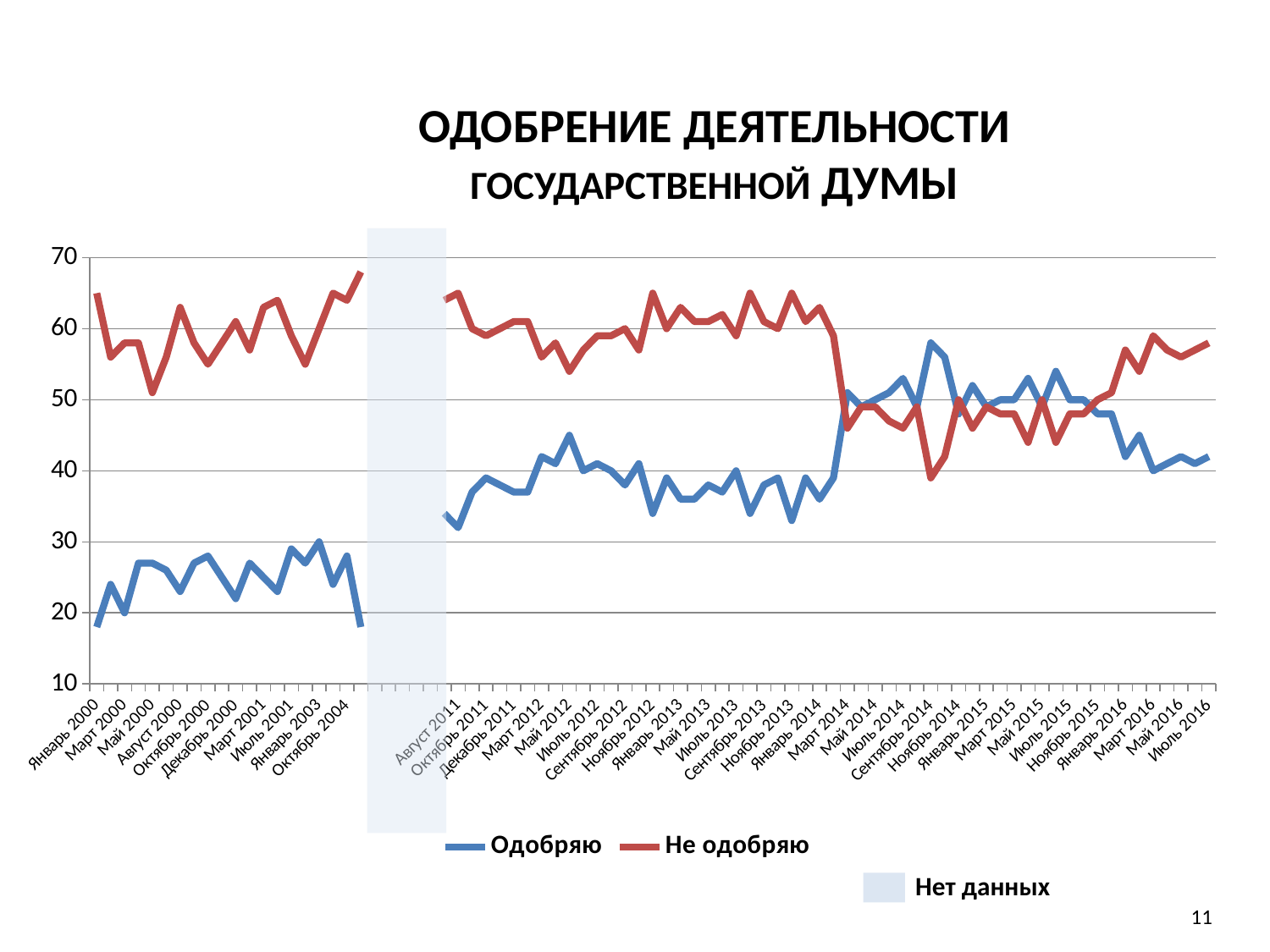
Is the value for Не одобряю in Сентябрь 2014 greater or less than 50? less Is the value for Одобряю in Январь 2000 greater or less than 20? less How many series does the chart legend list? 2 In Январь 2000, which series has the higher value, Одобряю or Не одобряю? Не одобряю What kind of chart is shown on the slide? line chart Does the Одобряю line rise or fall from Ноябрь 2015 to Март 2016? fall In Сентябрь 2014, which series has the higher value, Одобряю or Не одобряю? Одобряю Is the value for Не одобряю in Октябрь 2004 greater or less than 60? greater What are the two series named in the chart legend? Одобряю and Не одобряю What does the shaded vertical band in the chart represent, according to the slide? Нет данных